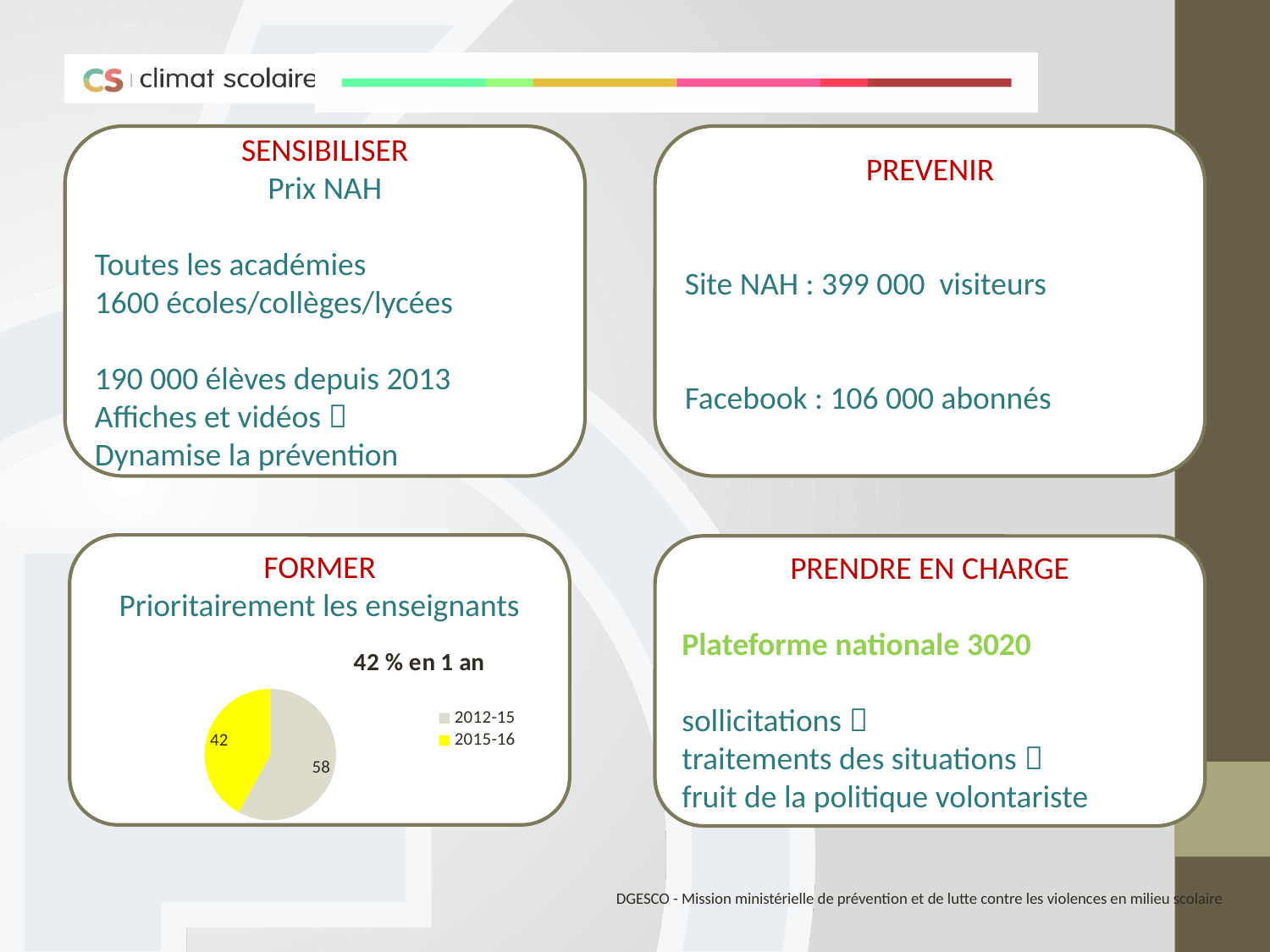
Which slice of the pie chart is the smallest? 2015-16 What is the title of the pie chart in the FORMER box? 42 % en 1 an What is the value of the 2012-15 slice in the pie chart? 58 Which slice of the pie chart is the largest? 2012-15 What colour is the 2015-16 slice in the pie chart? yellow How many entries does the pie chart's legend list? 2 Which is larger in the pie chart, 2012-15 or 2015-16? 2012-15 What kind of chart is shown in the FORMER box? pie chart What is the total of the two slices in the pie chart? 100 What is the value of the 2015-16 slice in the pie chart? 42 How many slices does the pie chart have? 2 What is the difference between the 2012-15 and 2015-16 values in the pie chart? 16